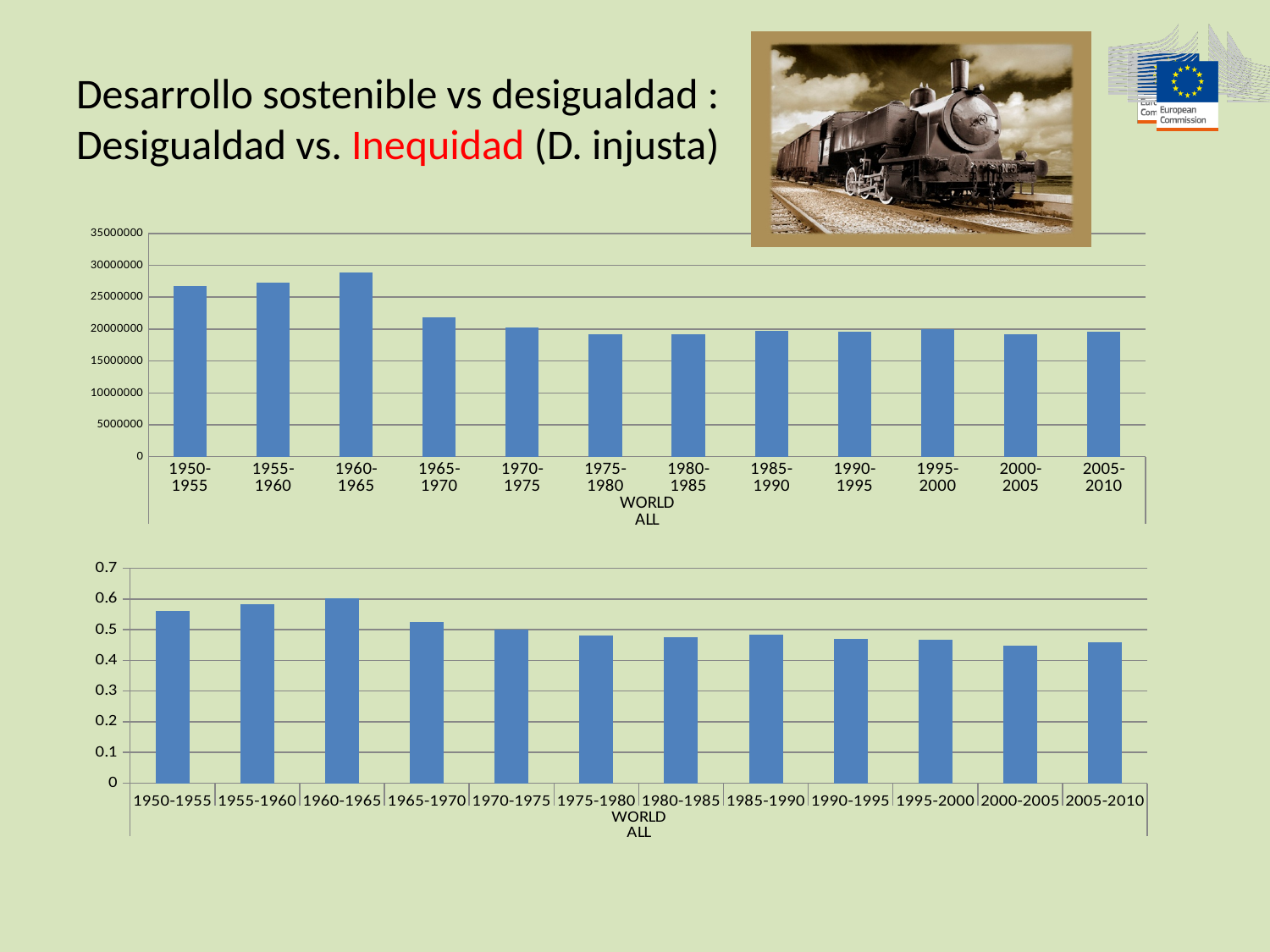
In the top chart, which is larger, the value for 1950-1955 or the value for 1965-1970? 1950-1955 In the bottom chart, which period has the highest bar? 1960-1965 What label appears under the x axis categories of both charts? WORLD ALL In the bottom chart, which is larger, the value for 1955-1960 or the value for 1990-1995? 1955-1960 In the bottom chart, is the value for 2000-2005 greater or less than 0.5? less In the bottom chart, do the values generally rise or fall from 1960-1965 to 2005-2010? fall In the bottom chart, is the value for 1950-1955 greater or less than 0.5? greater In the top chart, is the value for 1960-1965 greater or less than 25000000? greater What kind of chart is the top chart on the slide? bar chart In the top chart, which period has the highest bar? 1960-1965 How many time periods are shown on the x axis of the bottom chart? 12